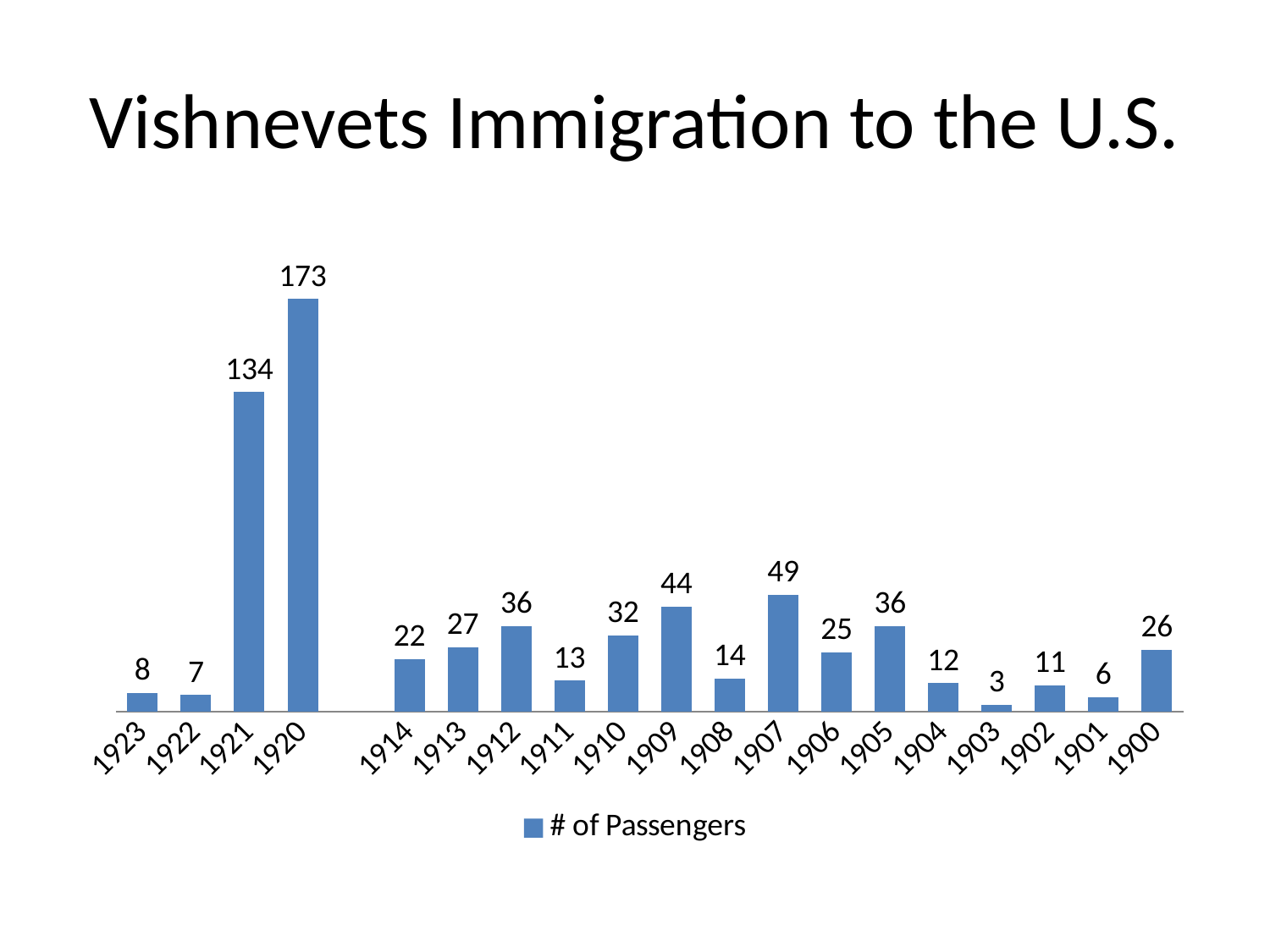
What is the number of passengers for 1900? 26 What is the number of passengers for 1920? 173 What is the number of passengers for 1903? 3 Which year has the highest number of passengers? 1920 What kind of chart is shown on the slide? Bar chart Which year has the lowest number of passengers? 1903 Which year has more passengers, 1912 or 1910? 1912 What is the difference in passengers between 1920 and 1921? 39 How many series does the legend list? 1 What is the number of passengers for 1907? 49 How many years are labeled on the x axis? 19 What is the difference in passengers between 1907 and 1909? 5